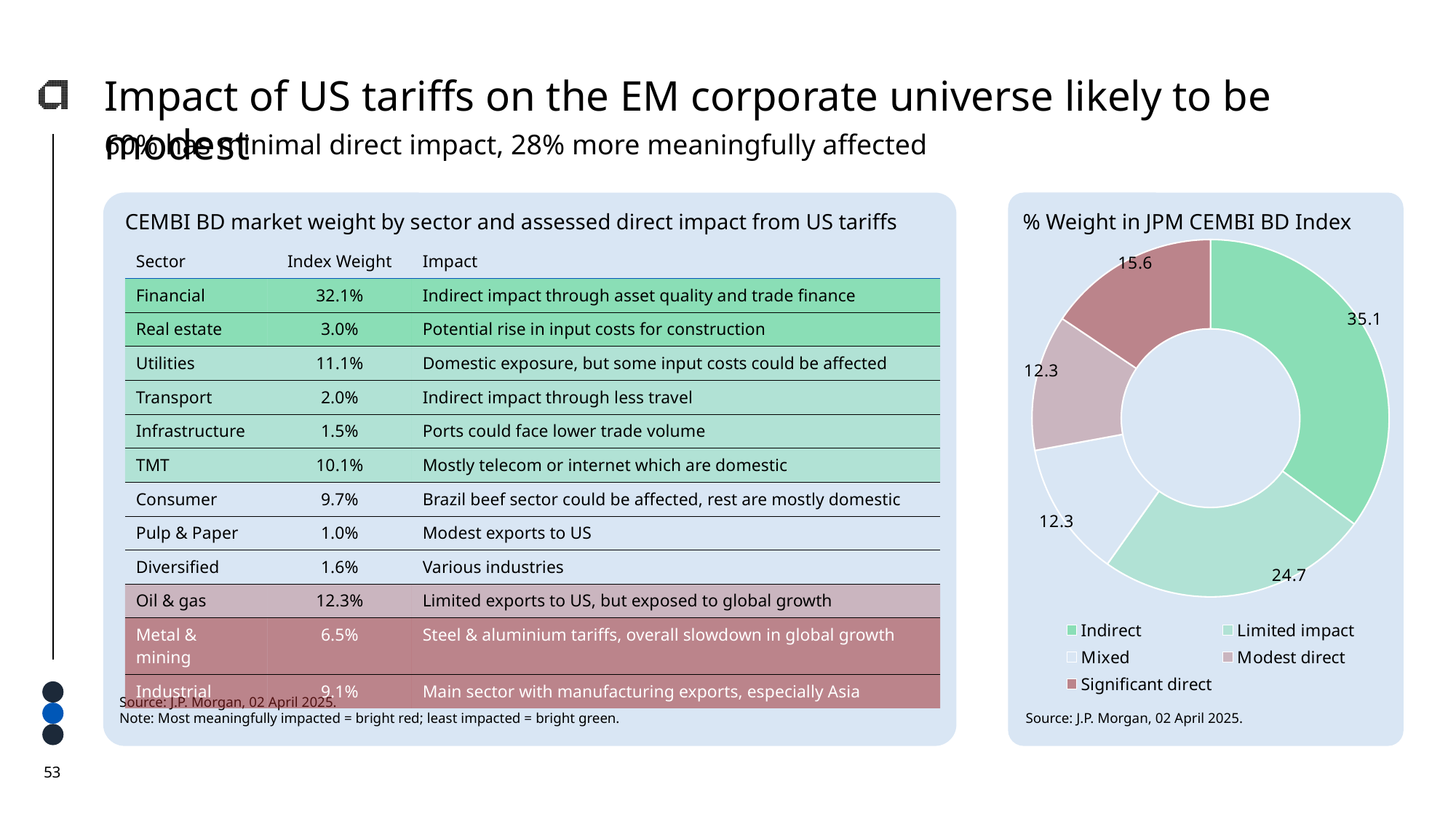
In the '% Weight in JPM CEMBI BD Index' chart, what is the value for the Limited impact slice? 24.7 In the '% Weight in JPM CEMBI BD Index' chart, what is the value for the Indirect slice? 35.1 What kind of chart is the '% Weight in JPM CEMBI BD Index' chart? doughnut chart How many entries does the legend of the '% Weight in JPM CEMBI BD Index' chart list? 5 In the '% Weight in JPM CEMBI BD Index' chart, what is the value for the Significant direct slice? 15.6 In the '% Weight in JPM CEMBI BD Index' chart, which is larger, Significant direct or Modest direct? Significant direct In the '% Weight in JPM CEMBI BD Index' chart, what is the difference between the Significant direct and Modest direct values? 3.3 In the '% Weight in JPM CEMBI BD Index' chart, what is the value for the Modest direct slice? 12.3 In the '% Weight in JPM CEMBI BD Index' chart, what is the difference between the Indirect and Limited impact values? 10.4 How many slices does the '% Weight in JPM CEMBI BD Index' chart have? 5 In the '% Weight in JPM CEMBI BD Index' chart, which category has the largest slice? Indirect In the '% Weight in JPM CEMBI BD Index' chart, which is larger, Limited impact or Mixed? Limited impact